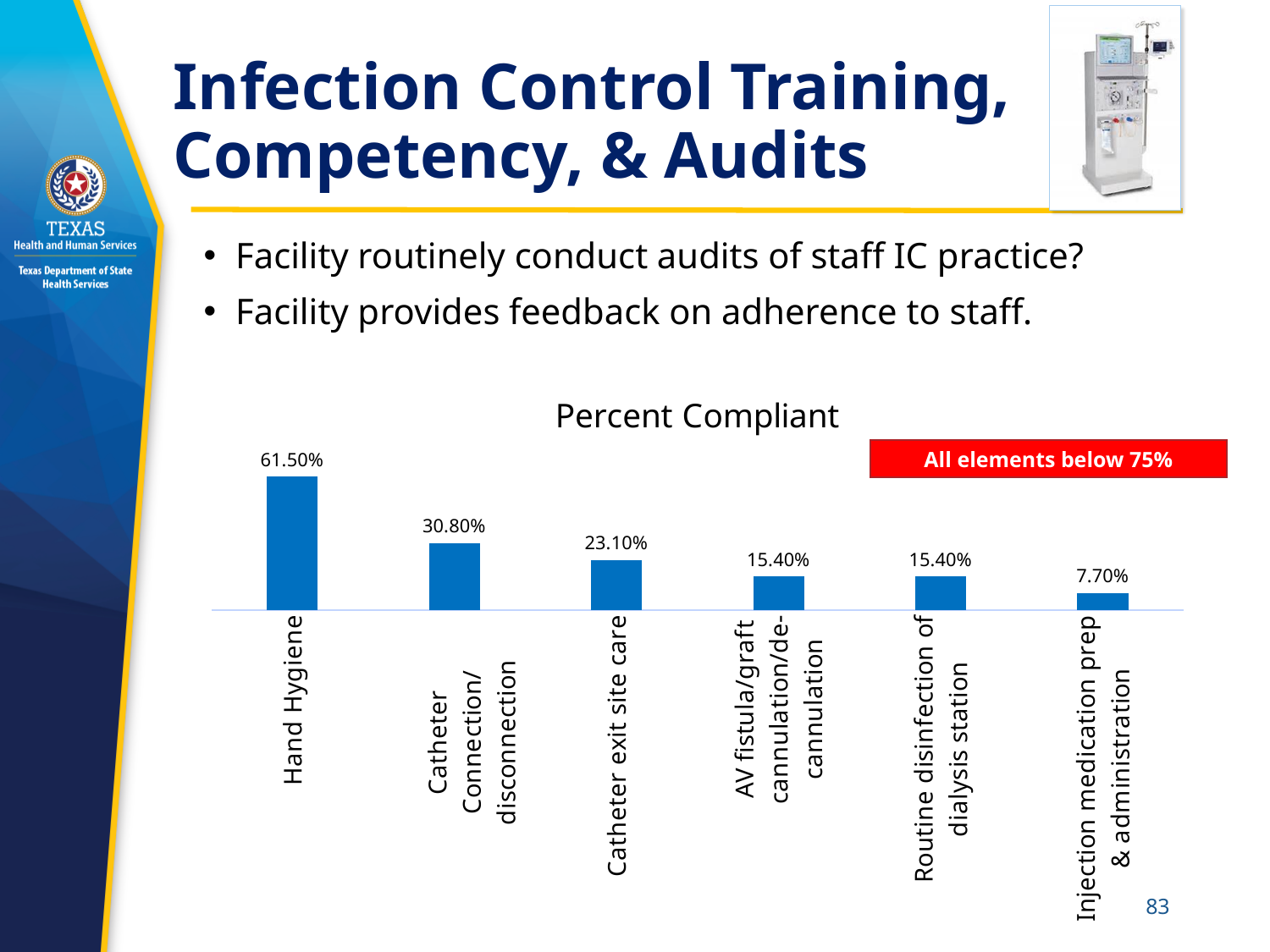
What is the value for Hand Hygiene? 61.50% Which is larger, the value for Catheter exit site care or the value for Injection medication prep & administration? Catheter exit site care What is the title of the chart? Percent Compliant How many categories are shown in the chart? 6 What is the difference between the values for Catheter exit site care and Routine disinfection of dialysis station? 7.70% What is the value for Catheter exit site care? 23.10% Which category has the lowest percent compliant? Injection medication prep & administration Which category has the highest percent compliant? Hand Hygiene What is the value for Catheter Connection/disconnection? 30.80% What is the value for Injection medication prep & administration? 7.70% What kind of chart is shown on the slide? Bar chart What is the difference between the values for Hand Hygiene and Catheter Connection/disconnection? 30.70%